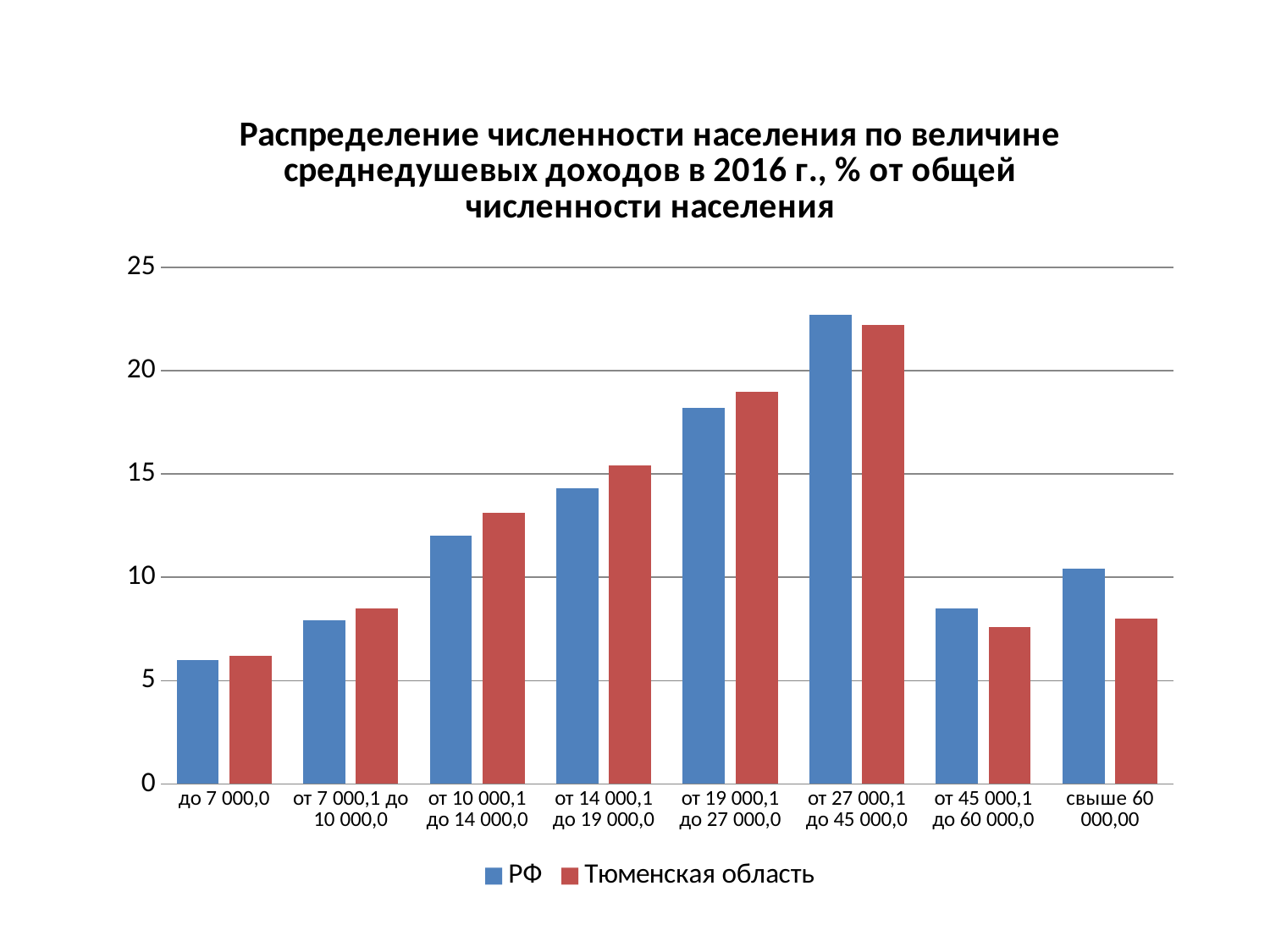
What kind of chart is shown on the slide? bar chart Which income category has the lowest value for РФ? до 7 000,0 How many income categories are shown on the x axis? 8 For the category 'свыше 60 000,00', which series has the larger value, РФ or Тюменская область? РФ Is the value for Тюменская область in the category 'свыше 60 000,00' greater or less than 10? less Which series is shown in red in the legend? Тюменская область Which income category has the highest value for РФ? от 27 000,1 до 45 000,0 Is the value for РФ in the category 'от 27 000,1 до 45 000,0' greater or less than 20? greater Is the value for Тюменская область in the category 'от 10 000,1 до 14 000,0' greater or less than 10? greater For the category 'от 14 000,1 до 19 000,0', which series has the larger value, РФ or Тюменская область? Тюменская область How many series does the legend list? 2 Which income category has the lowest value for Тюменская область? до 7 000,0